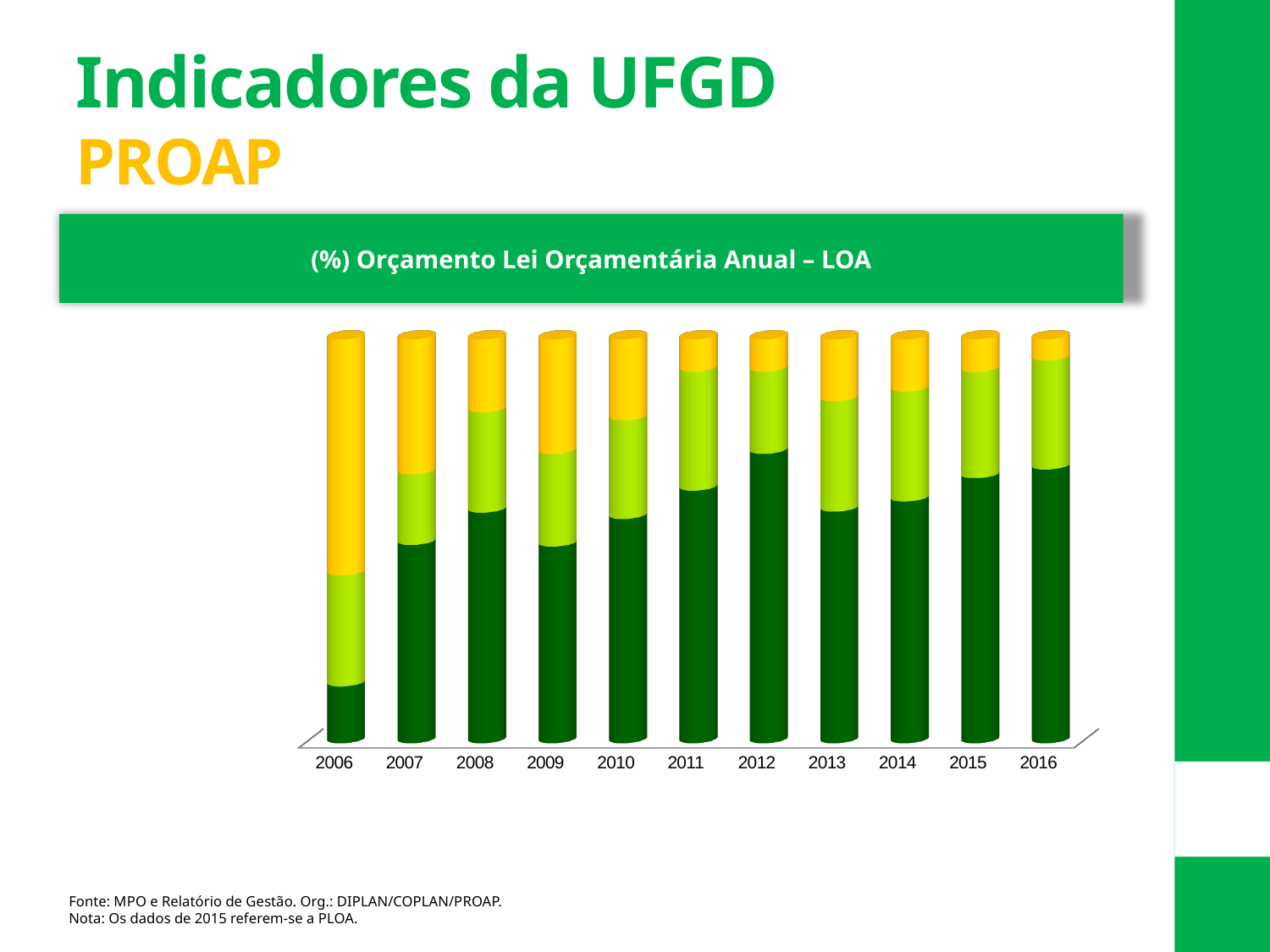
What is the title of the chart? (%) Orçamento Lei Orçamentária Anual – LOA How many years are shown on the x axis of the chart? 11 How many coloured segments make up each bar in the chart? 3 Is the dark green segment larger in 2006 or in 2016? 2016 Is the light green segment larger in 2007 or in 2008? 2008 Is the yellow segment larger in 2006 or in 2007? 2006 Which year has the largest yellow segment in the chart? 2006 Which year has the smallest dark green segment in the chart? 2006 Does the yellow segment generally rise or fall from 2006 to 2016? Fall What kind of chart is shown on the slide? Stacked bar chart Does the dark green segment generally rise or fall from 2006 to 2016? Rise